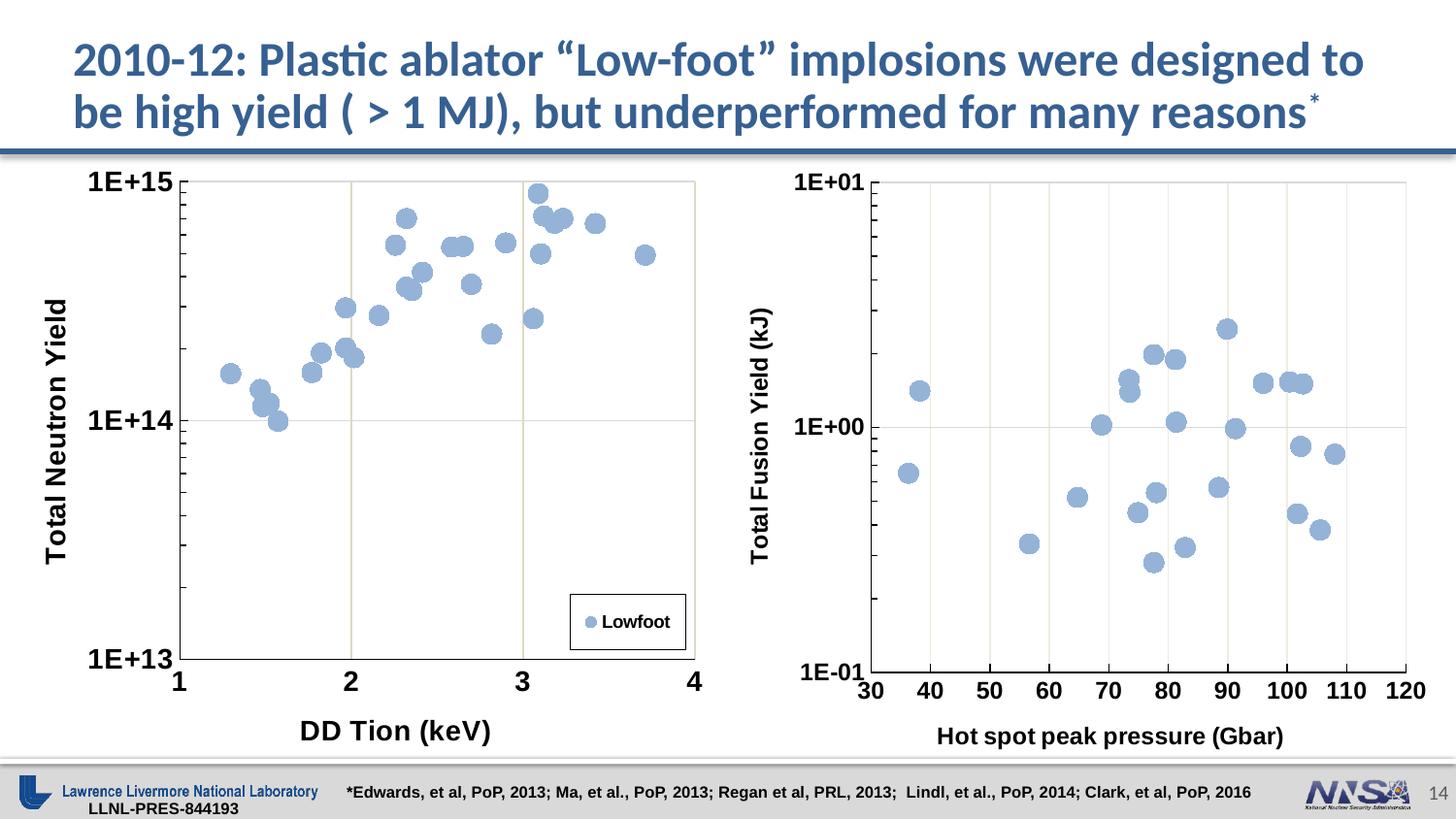
On the right chart, what is the label of the y axis? Total Fusion Yield (kJ) On the left chart, what is the label of the x axis? DD Tion (keV) What kind of chart is the right chart (Total Fusion Yield vs Hot spot peak pressure)? scatter chart What kind of chart is the left chart (Total Neutron Yield vs DD Tion)? scatter chart On the right chart, is the Total Fusion Yield for the point near 57 Gbar greater or less than 1E+00? less On the left chart, what is the highest value shown on the y axis? 1E+15 On the left chart, does Total Neutron Yield generally rise or fall as DD Tion increases? rise On the left chart, how many series does the legend list? 1 On the left chart, is the Total Neutron Yield for the point at about 1.3 keV greater or less than 1E+14? greater On the right chart, is the highest plotted Total Fusion Yield greater or less than 1E+01? less